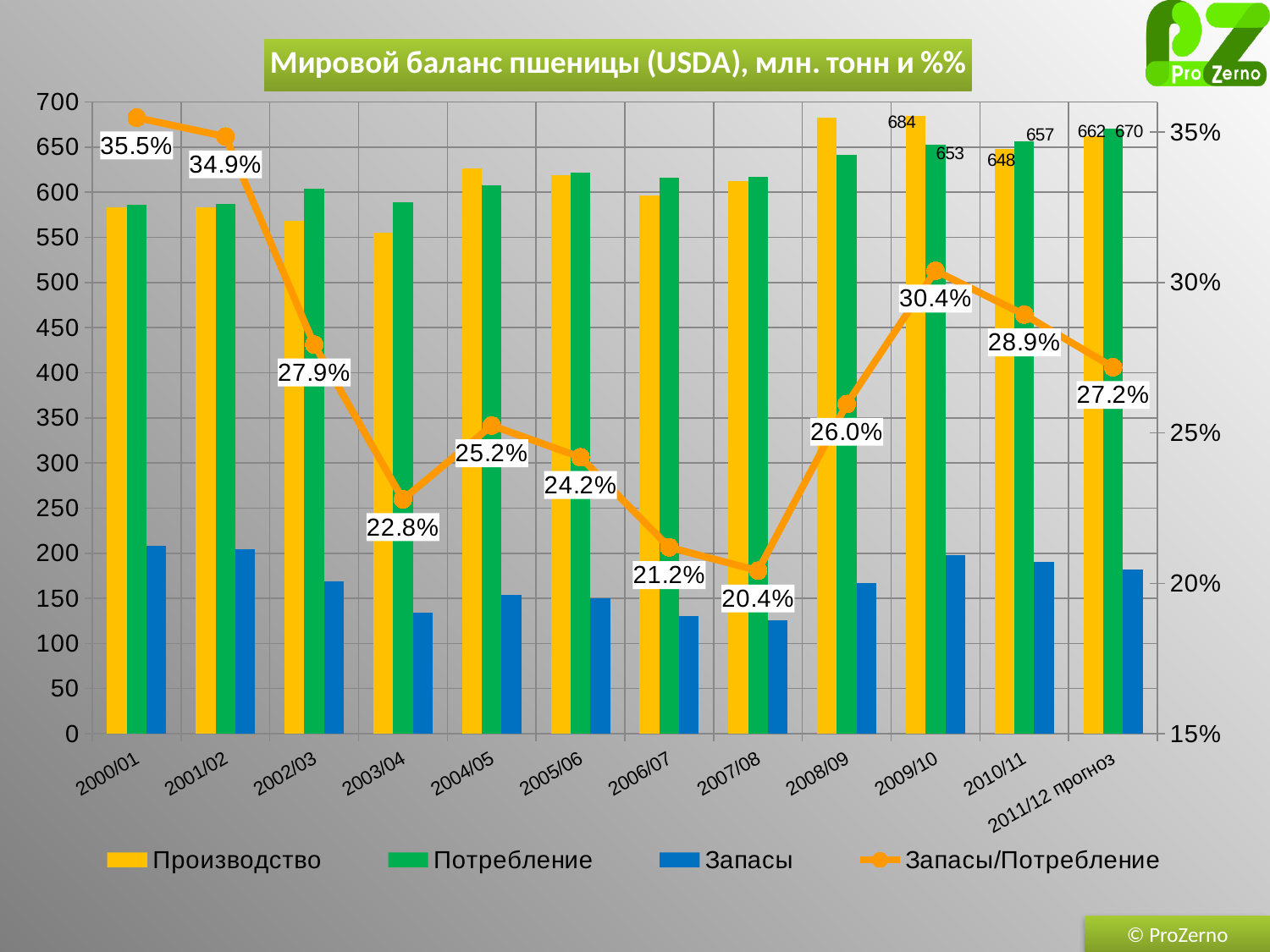
What is the value of Потребление for 2011/12 прогноз? 670 How many seasons are shown on the x axis? 12 Is the value of Запасы for 2000/01 greater or less than 200? greater How many series does the legend list? 4 What is the value of Производство for 2009/10? 684 What kind of chart is this? Combination bar and line chart What is the value of Запасы/Потребление for 2000/01? 35.5% In 2009/10, which is larger: Производство or Потребление? Производство In which season is the Запасы/Потребление ratio lowest? 2007/08 What is the difference between Потребление and Производство in 2010/11? 9 Does the Запасы/Потребление line rise or fall from 2000/01 to 2003/04? fall In which season is the Запасы/Потребление ratio highest? 2000/01